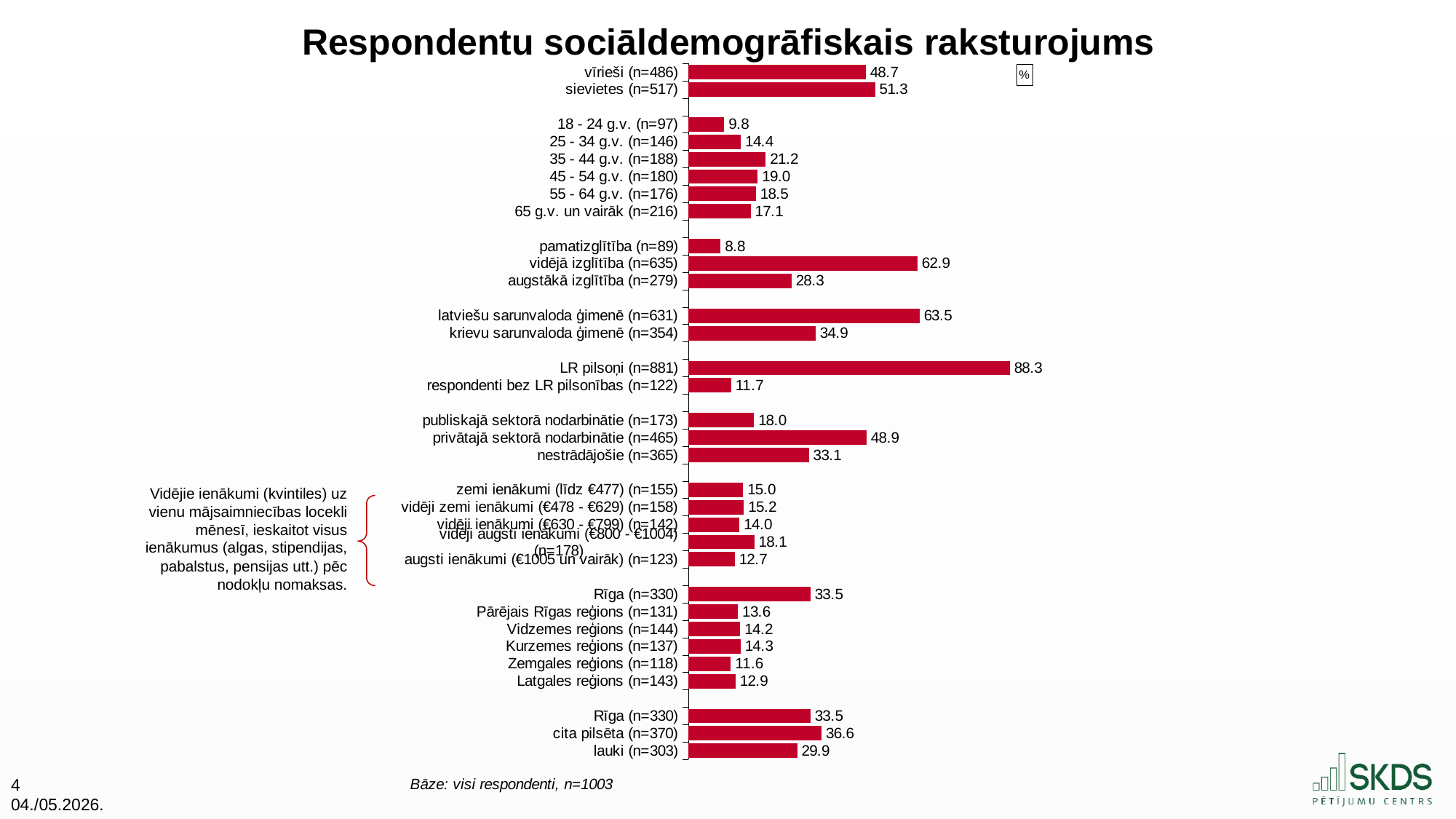
Which category has the lowest value on the chart? pamatizglītība (n=89) What is the value for Zemgales reģions (n=118)? 11.6 How many bars are plotted on the chart? 32 What is the difference between the values for latviešu sarunvaloda ģimenē (n=631) and krievu sarunvaloda ģimenē (n=354)? 28.6 What kind of chart is shown on the slide? bar chart What is the value for sievietes (n=517)? 51.3 Which category has the highest value on the chart? LR pilsoņi (n=881) What is the value for vidējā izglītība (n=635)? 62.9 What is the difference between the values for cita pilsēta (n=370) and lauki (n=303)? 6.7 What is the title of the chart? Respondentu sociāldemogrāfiskais raksturojums Which age group has the highest value? 35 - 44 g.v. (n=188) Which is larger, the value for privātajā sektorā nodarbinātie (n=465) or nestrādājošie (n=365)? privātajā sektorā nodarbinātie (n=465)